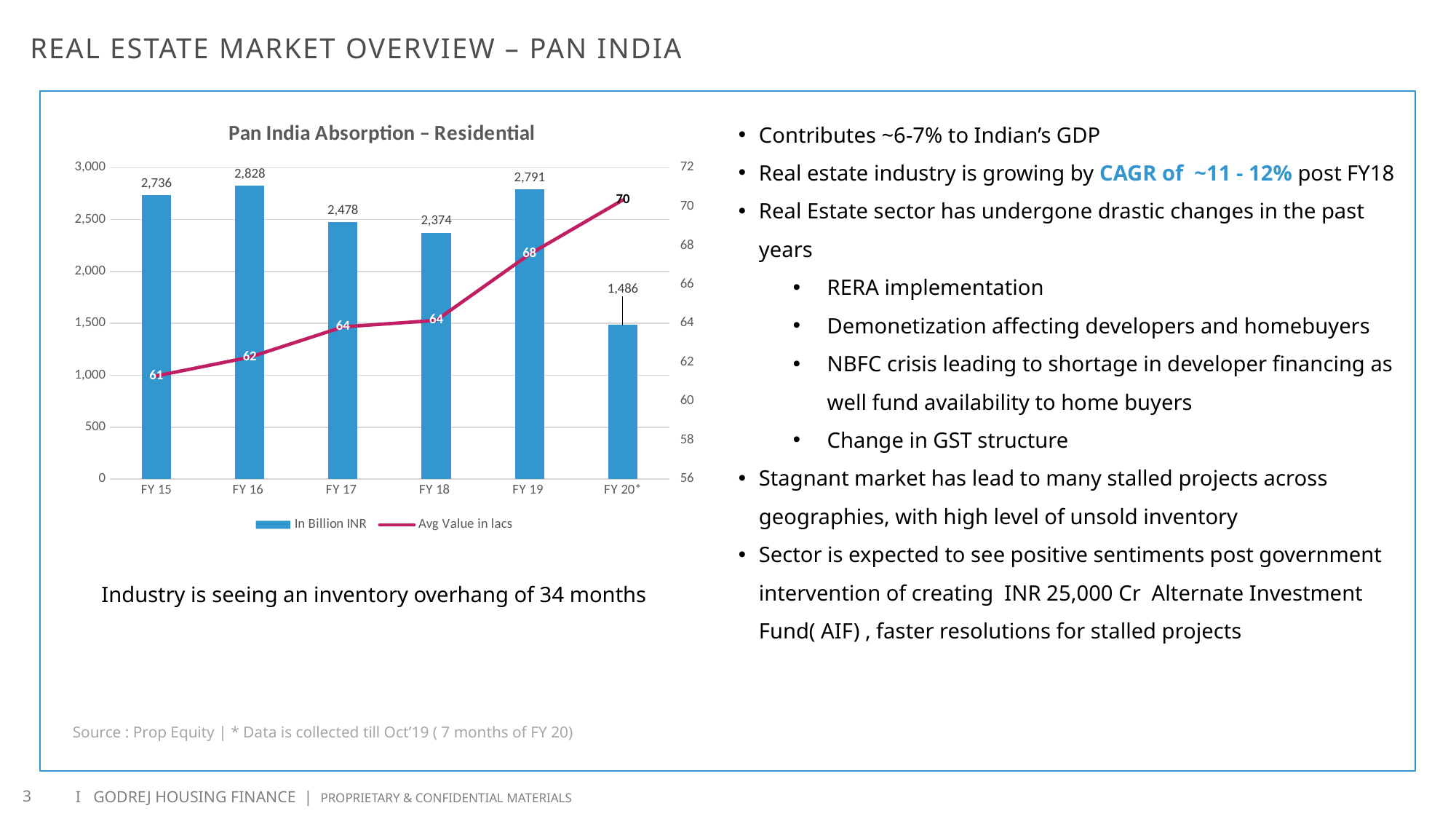
What is the Avg Value in lacs for FY 19? 68 Is the In Billion INR value for FY 20* greater or less than 2,000? less Which fiscal year has the highest In Billion INR bar? FY 16 How many fiscal years are shown on the x axis? 6 Which is larger, the In Billion INR value for FY 15 or FY 17? FY 15 Which fiscal year has the lowest In Billion INR bar? FY 20* Does the Avg Value in lacs line rise or fall from FY 15 to FY 20*? rise What is the title of the chart? Pan India Absorption – Residential What kind of chart is used for the In Billion INR series? bar chart How many series does the legend list? 2 What is the difference between the In Billion INR values for FY 19 and FY 18? 417 What is the value of the In Billion INR bar for FY 16? 2,828